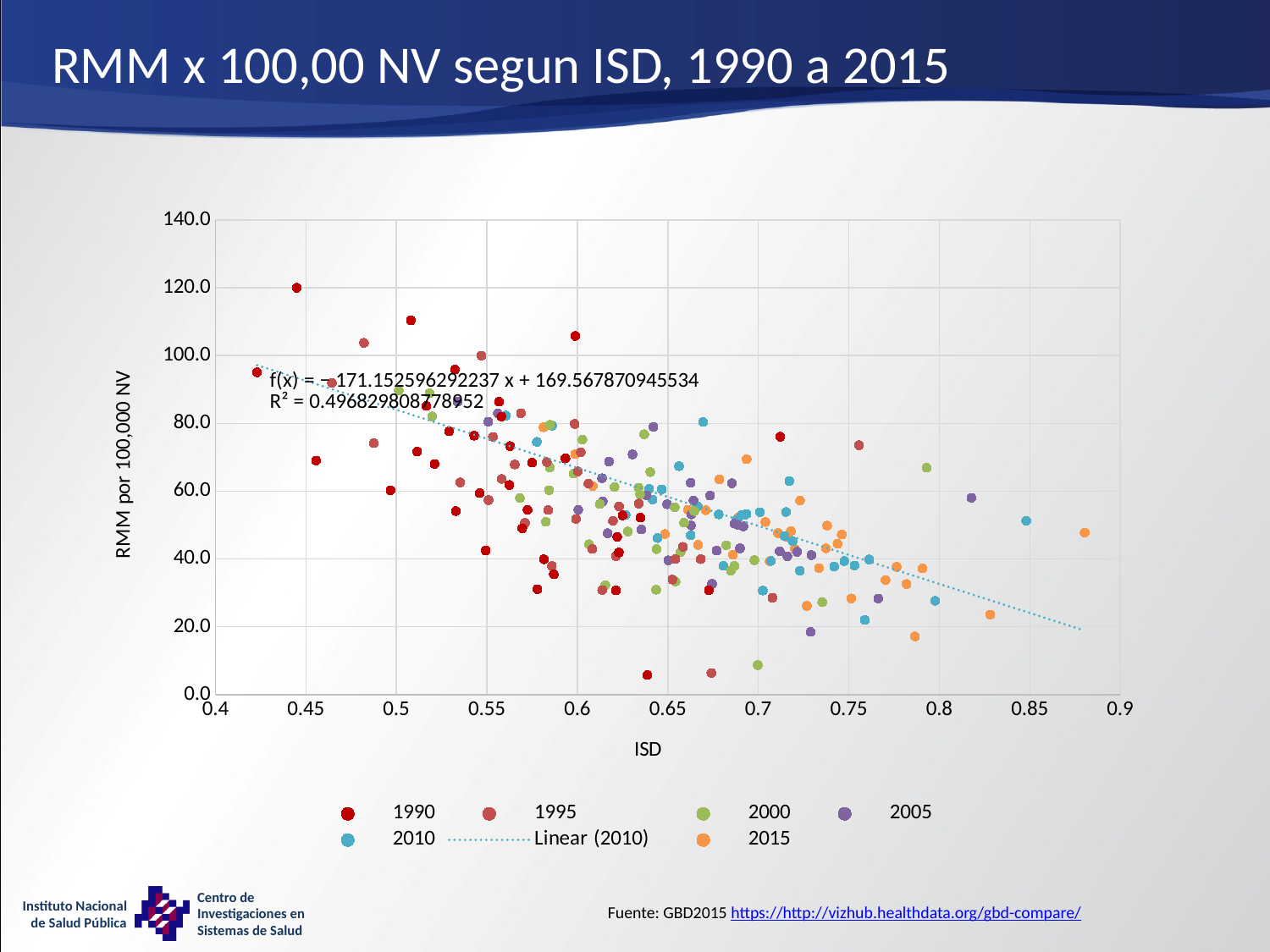
Is the highest plotted point on the chart greater or less than 100? greater How many data series (years) does the legend list, excluding the trendline? 6 What is the label of the x axis? ISD As ISD increases along the x axis, do the RMM values generally rise or fall? Fall Which series contains the highest plotted point on the chart? 1990 What is the R² value shown for the linear trendline? 0.496829808778952 How many entries does the legend list in total, including the trendline? 7 What kind of chart is shown on the slide? Scatter chart What is the maximum value shown on the y axis? 140.0